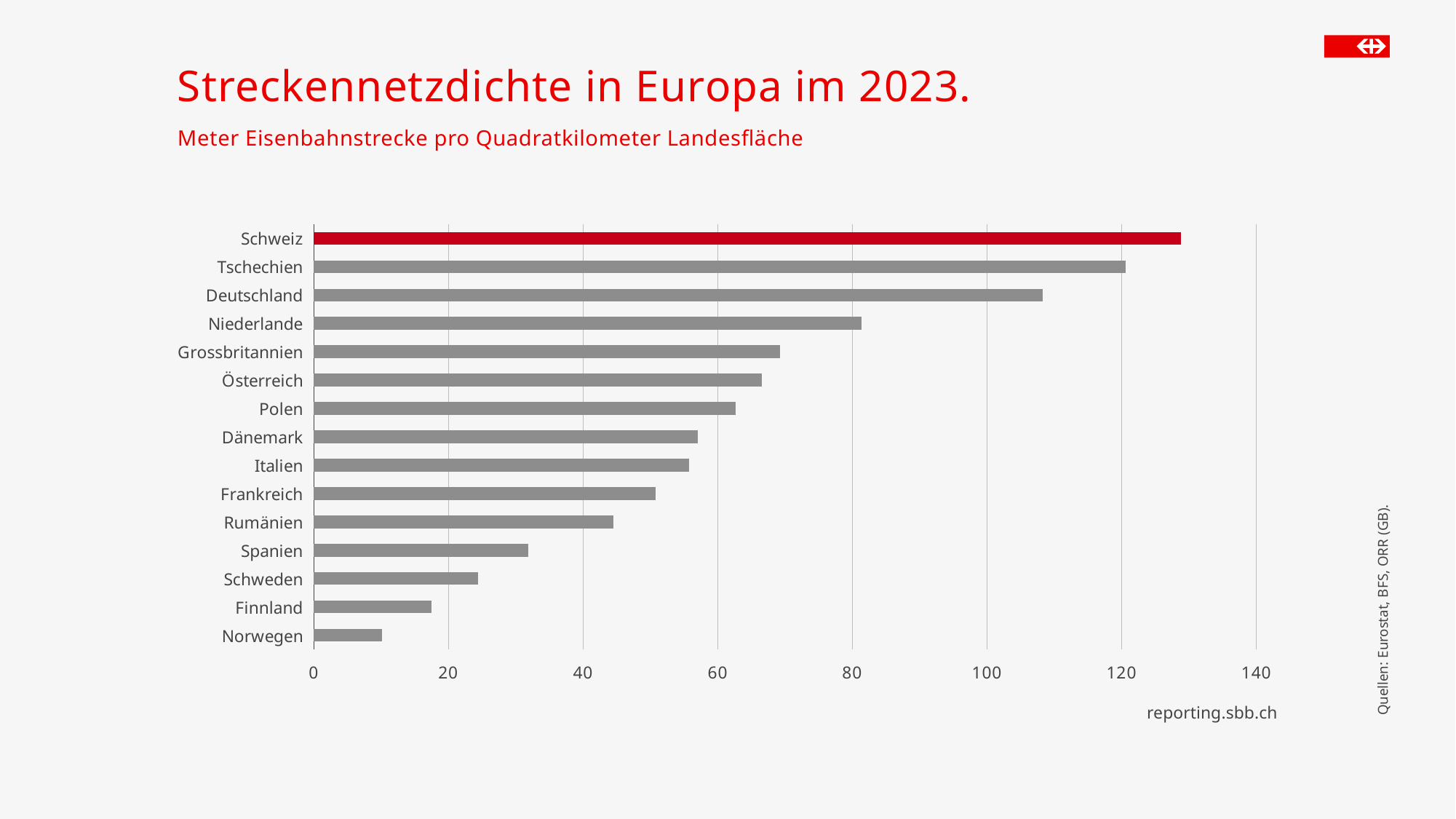
Which has a larger value, Deutschland or Niederlande? Deutschland Is the value for Deutschland greater or less than 100? greater Which country has the highest value in the chart? Schweiz Is the value for Spanien greater or less than 40? less Which has a larger value, Schweden or Spanien? Spanien Which country's bar is highlighted in red? Schweiz Is the value for Schweiz greater or less than 120? greater How many countries are shown in the chart? 15 What kind of chart is shown on the slide? bar chart Which country has the lowest value in the chart? Norwegen